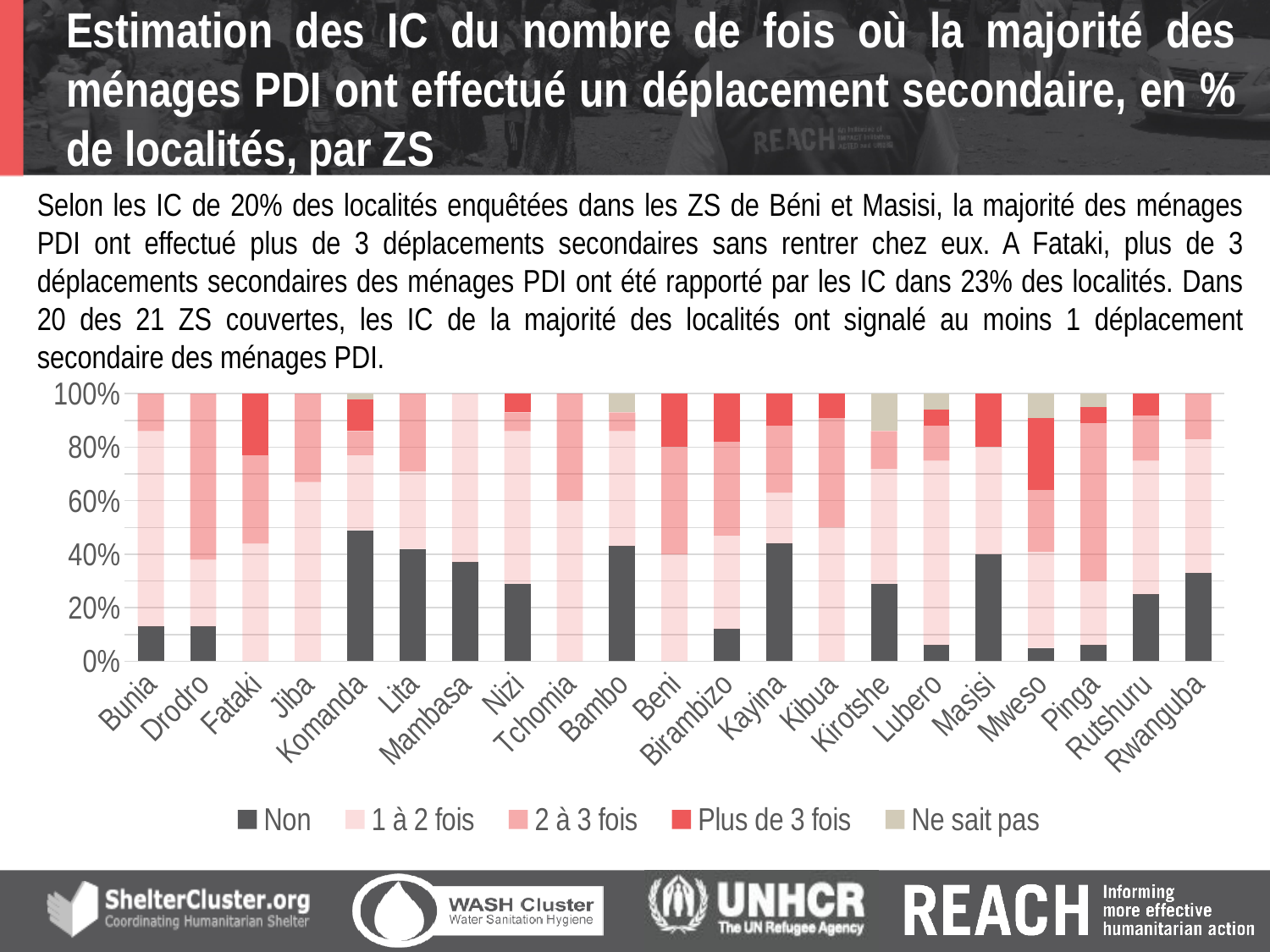
Which series is shown in dark grey at the bottom of each bar? Non Is the 'Non' value for Lubero greater or less than 20%? less What kind of chart is shown on the slide? Stacked bar chart How many series does the chart legend list? 5 What is the highest value shown on the y axis of the chart? 100% Is the 'Non' value for Komanda greater or less than 40%? greater Is the 'Non' value for Rwanguba greater or less than 20%? greater How many zones de santé (categories) are shown along the x axis of the chart? 21 Which has the larger 'Non' value, Kayina or Mweso? Kayina Which has the larger 'Non' value, Komanda or Bunia? Komanda Which has the larger 'Non' value, Bambo or Lubero? Bambo